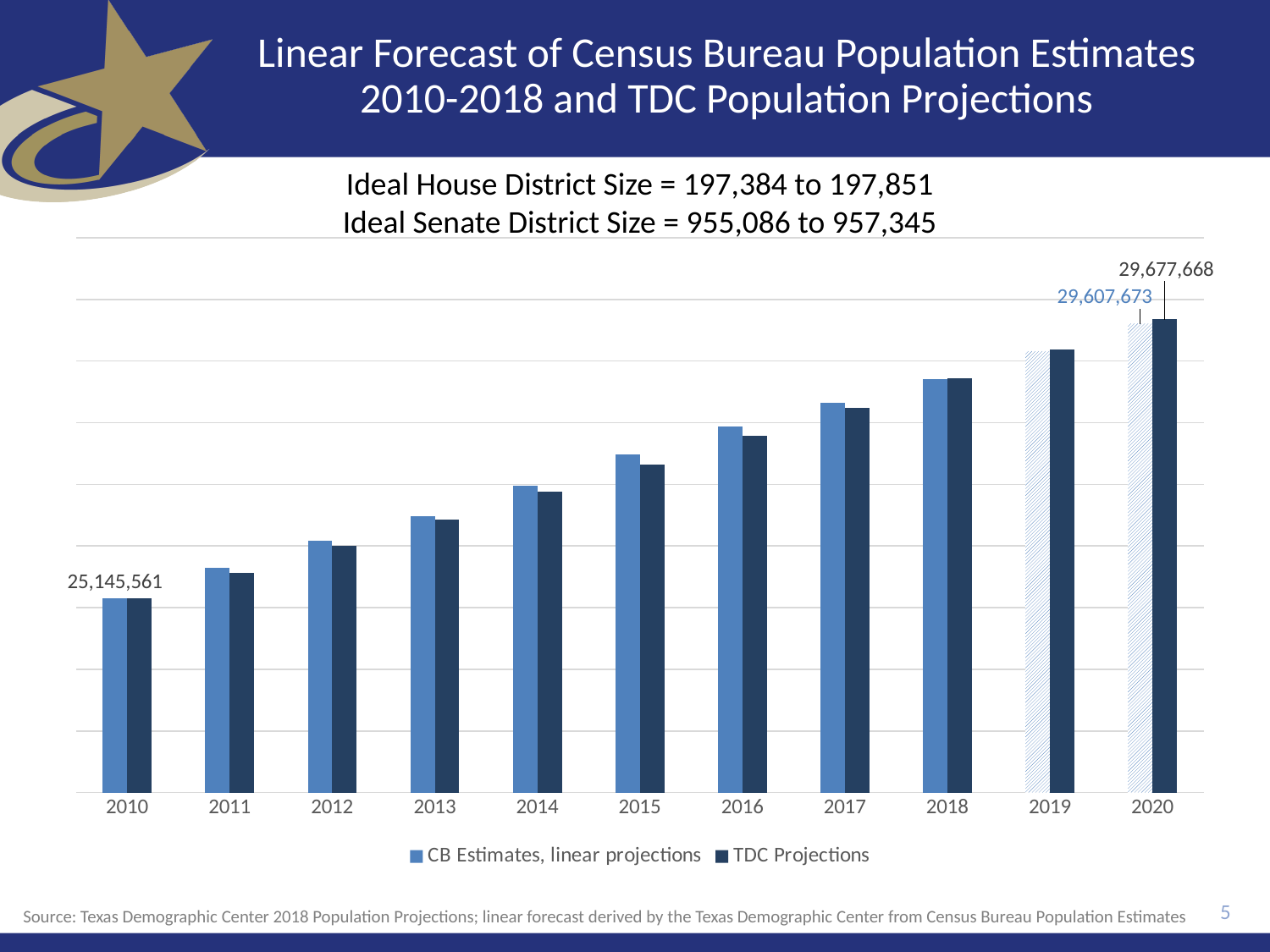
What type of chart is shown on the slide? bar chart How many years are shown on the x axis? 11 What is the TDC Projections value for 2020? 29,677,668 Do the TDC Projections values rise or fall from 2010 to 2020? rise What is the population value labelled for 2010? 25,145,561 For 2017, which is larger: the CB Estimates, linear projections value or the TDC Projections value? CB Estimates, linear projections Which year has the lowest CB Estimates, linear projections value? 2010 What is the CB Estimates, linear projections value for 2020? 29,607,673 Which year has the highest TDC Projections value? 2020 How many series does the legend list? 2 What is the difference between the TDC Projections and CB Estimates values for 2020? 69,995 For 2020, which is larger: the TDC Projections value or the CB Estimates, linear projections value? TDC Projections